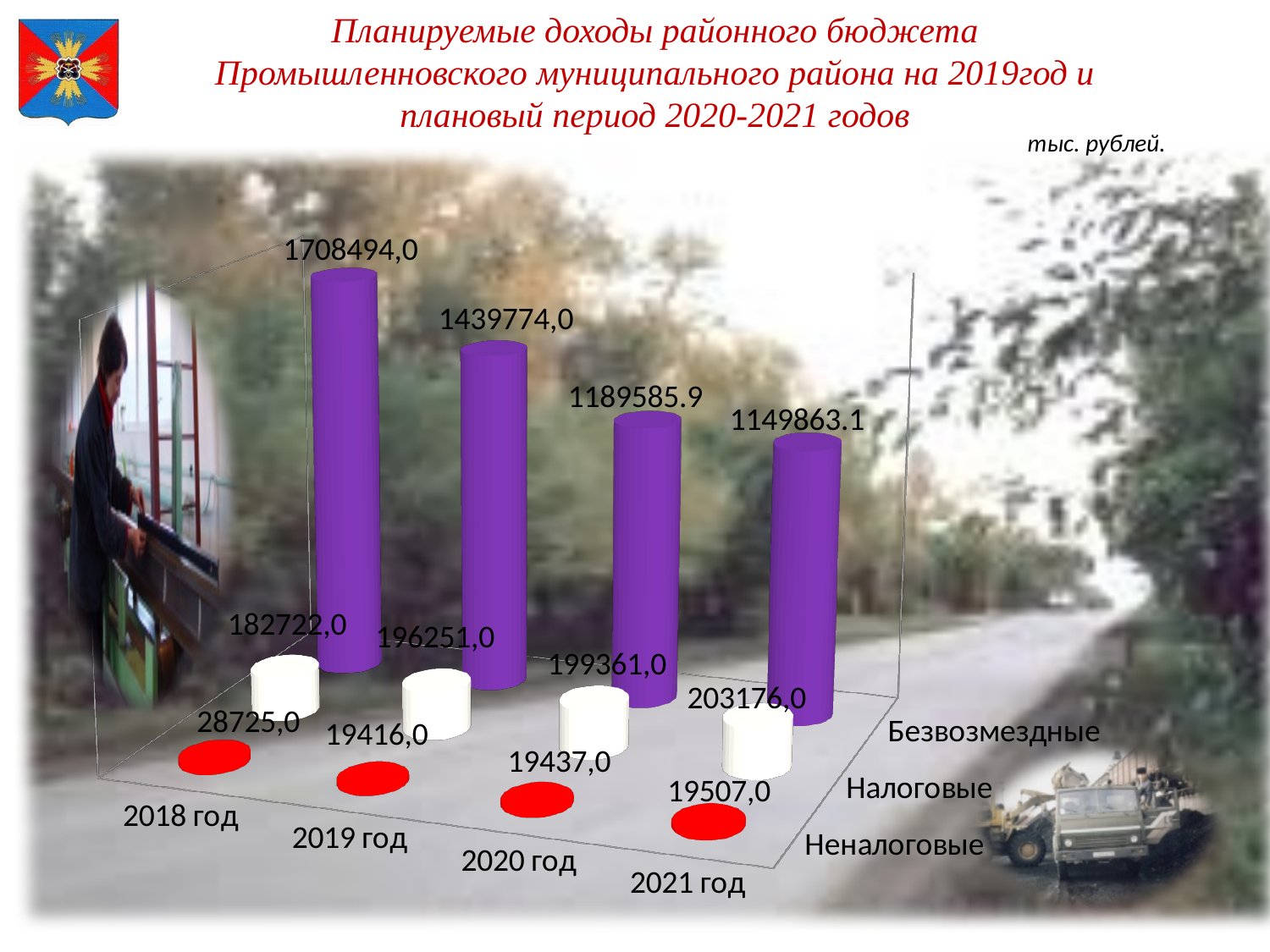
In which year is the value for Налоговые the lowest? 2018 год Which is larger: Безвозмездные in 2019 год or Безвозмездные in 2021 год? 2019 год What is the value for Налоговые in 2021 год? 203176,0 Do the Безвозмездные values rise or fall from 2018 год to 2021 год? fall What is the difference between the Налоговые values for 2021 год and 2018 год? 20454,0 How many series does the chart show? 3 What is the value for Безвозмездные in 2018 год? 1708494,0 How many years are shown on the chart? 4 What is the difference between the Неналоговые values for 2018 год and 2019 год? 9309,0 In which year is the value for Безвозмездные the highest? 2018 год What is the value for Безвозмездные in 2020 год? 1189585.9 What is the value for Неналоговые in 2019 год? 19416,0